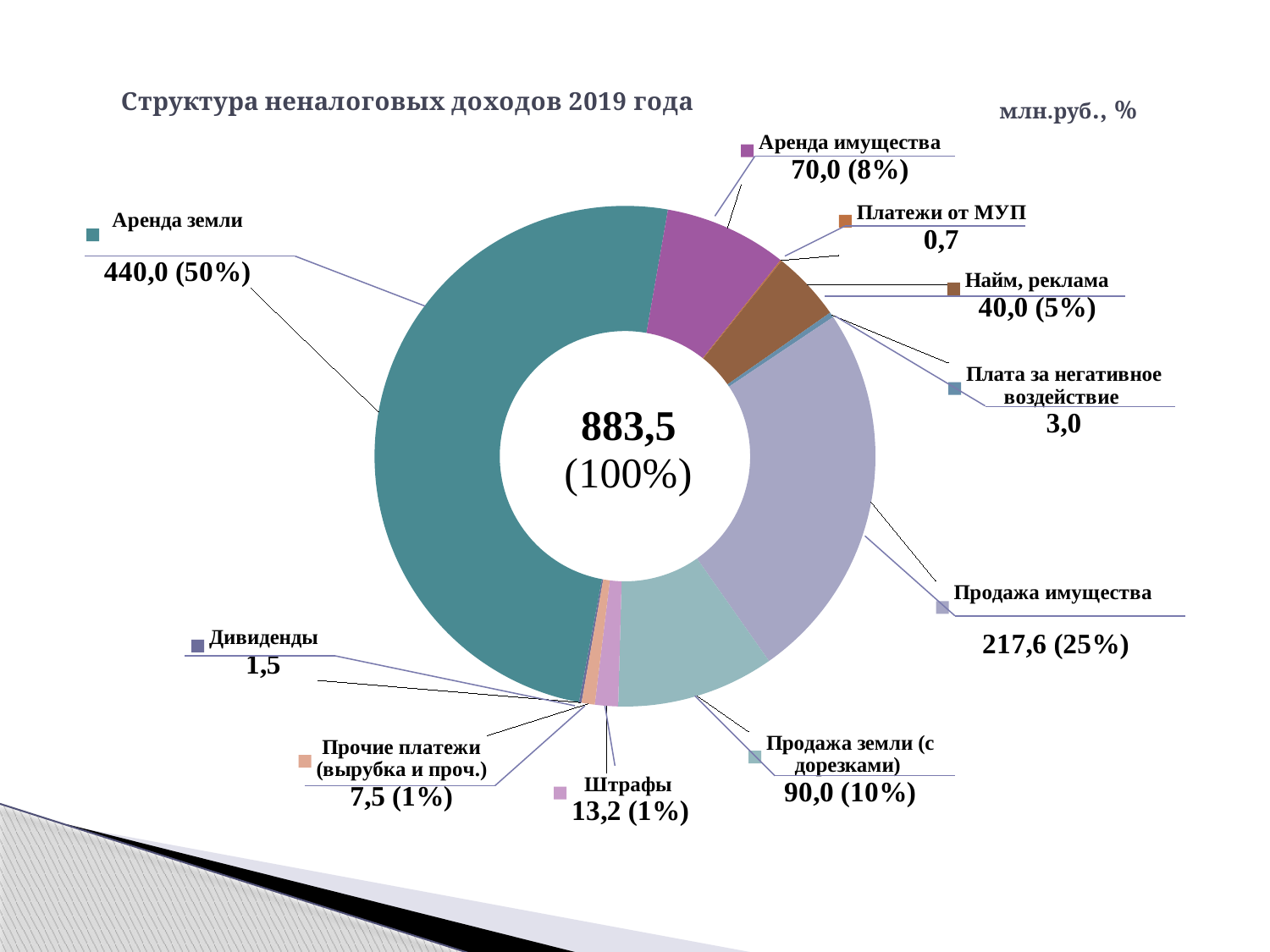
What is the value shown for Штрафы? 13,2 (1%) What is the value shown for Аренда земли? 440,0 (50%) What is the value shown for Платежи от МУП? 0,7 What is the value shown for Продажа имущества? 217,6 (25%) What is the title of the chart? Структура неналоговых доходов 2019 года Which category has the largest share of the chart? Аренда земли Which is larger: Аренда имущества or Найм, реклама? Аренда имущества What type of chart is shown on the slide? Doughnut (pie) chart What share of the chart does Продажа земли (с дорезками) represent? 10% How many categories are shown on the chart? 10 Which category has the smallest value on the chart? Платежи от МУП What is the total value shown in the centre of the chart? 883,5 (100%)